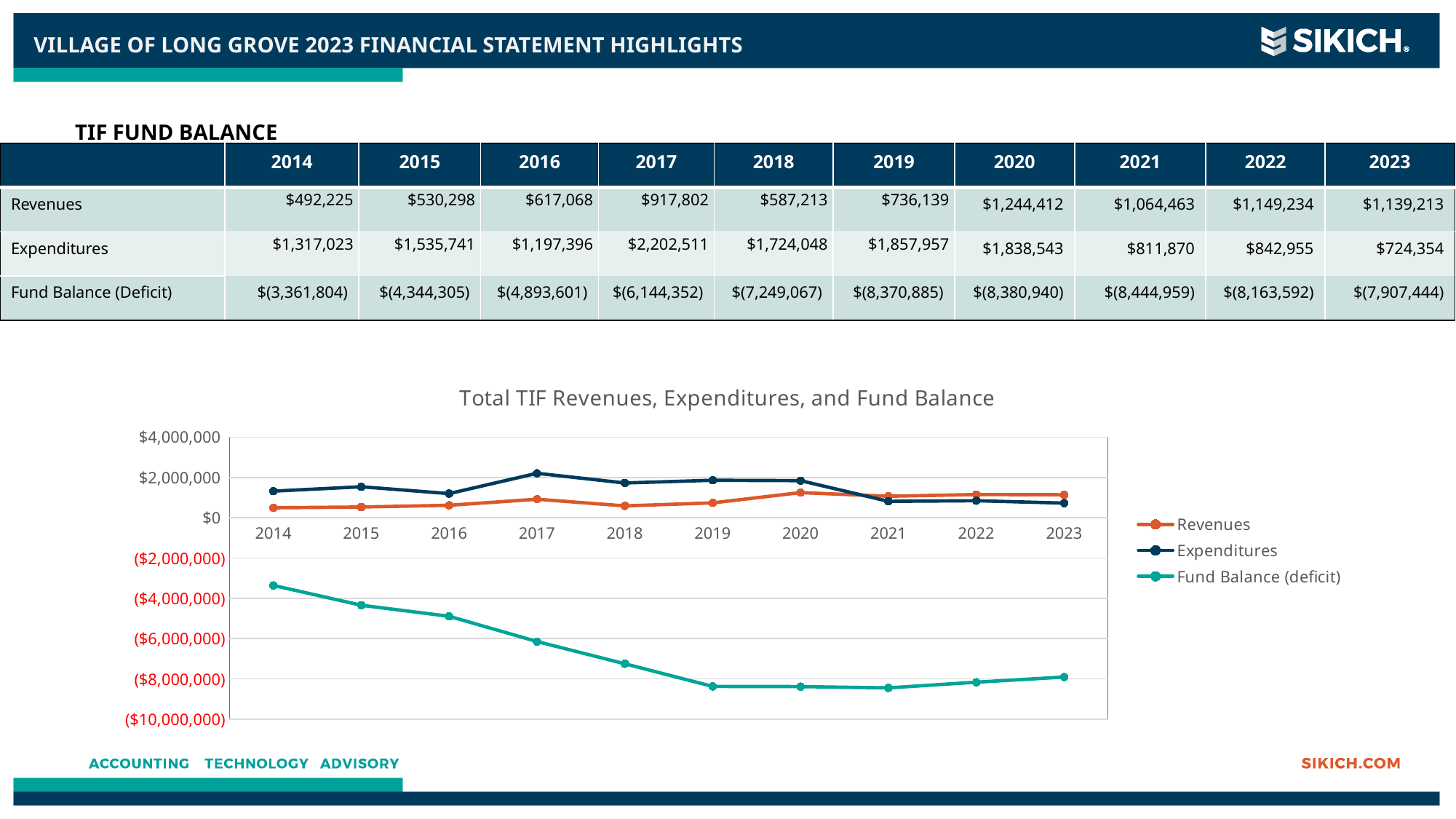
How many years are plotted along the x axis of the chart? 10 How many series does the legend of the chart list? 3 Does the Fund Balance (deficit) line rise or fall from 2014 to 2019? fall Which is larger in 2019, Revenues or Expenditures? Expenditures In which year is the Expenditures line at its highest? 2017 Is the Expenditures value for 2017 greater or less than $2,000,000? greater Which series in the chart is drawn in orange? Revenues In which year is the Fund Balance (deficit) line at its lowest? 2021 Is the Fund Balance (deficit) value for 2014 greater or less than ($4,000,000)? greater What is the title of the chart? Total TIF Revenues, Expenditures, and Fund Balance What kind of chart is "Total TIF Revenues, Expenditures, and Fund Balance"? line chart Is the Revenues value for 2020 greater or less than $2,000,000? less